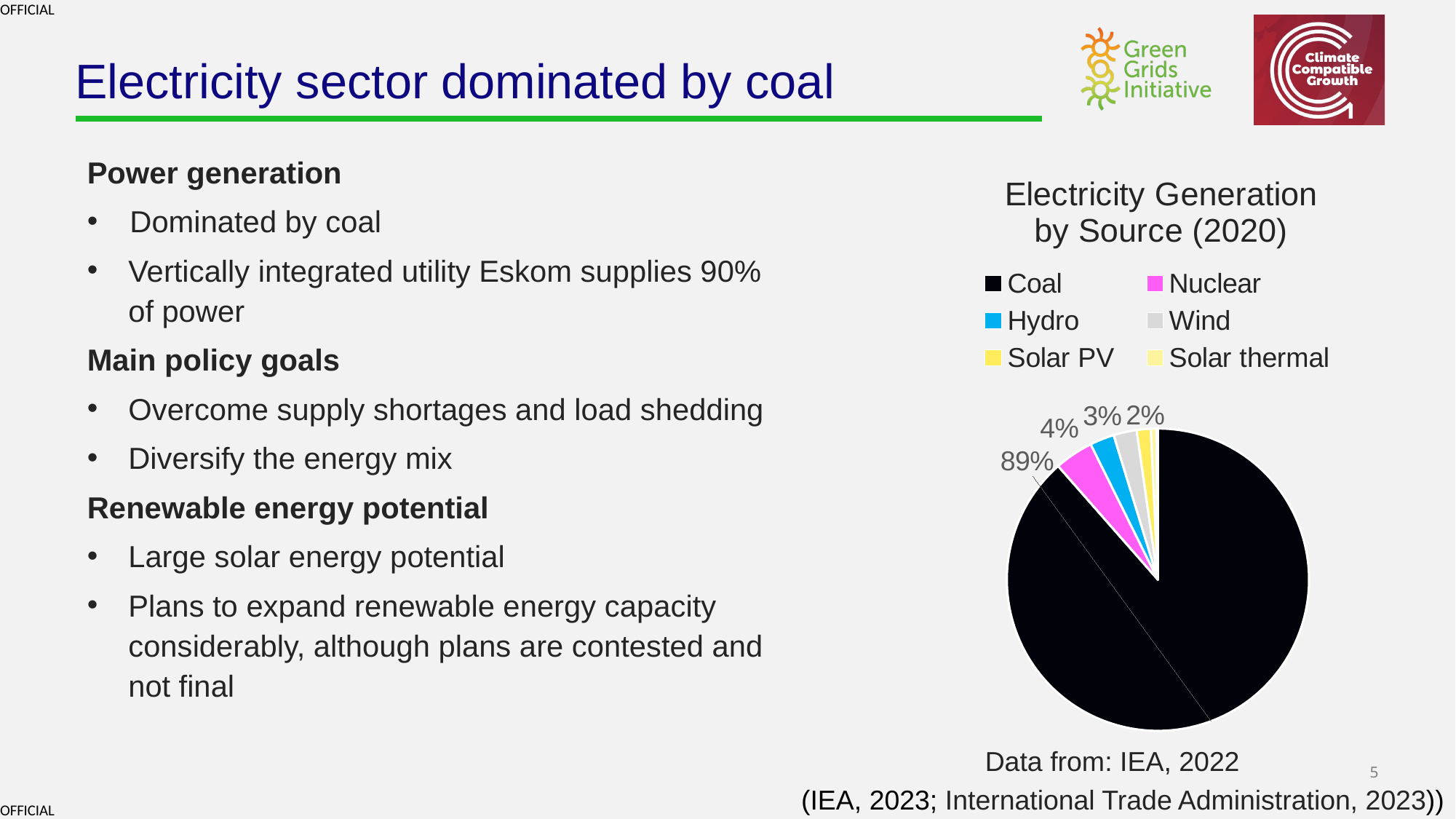
What colour is used for the Coal slice in the chart? black What is the value shown for Hydro? 3% What is the value shown for Wind? 2% What is the value shown for Nuclear? 4% How many sources does the chart's legend list? 6 What kind of chart is shown on the slide? pie chart Which is larger, the share for Nuclear or the share for Hydro? Nuclear What is the difference in percentage points between Hydro and Wind? 1 Which source has the largest slice of the pie? Coal What is the title of the chart? Electricity Generation by Source (2020) What is the difference in percentage points between Coal and Nuclear? 85 What share of electricity generation does Coal account for? 89%